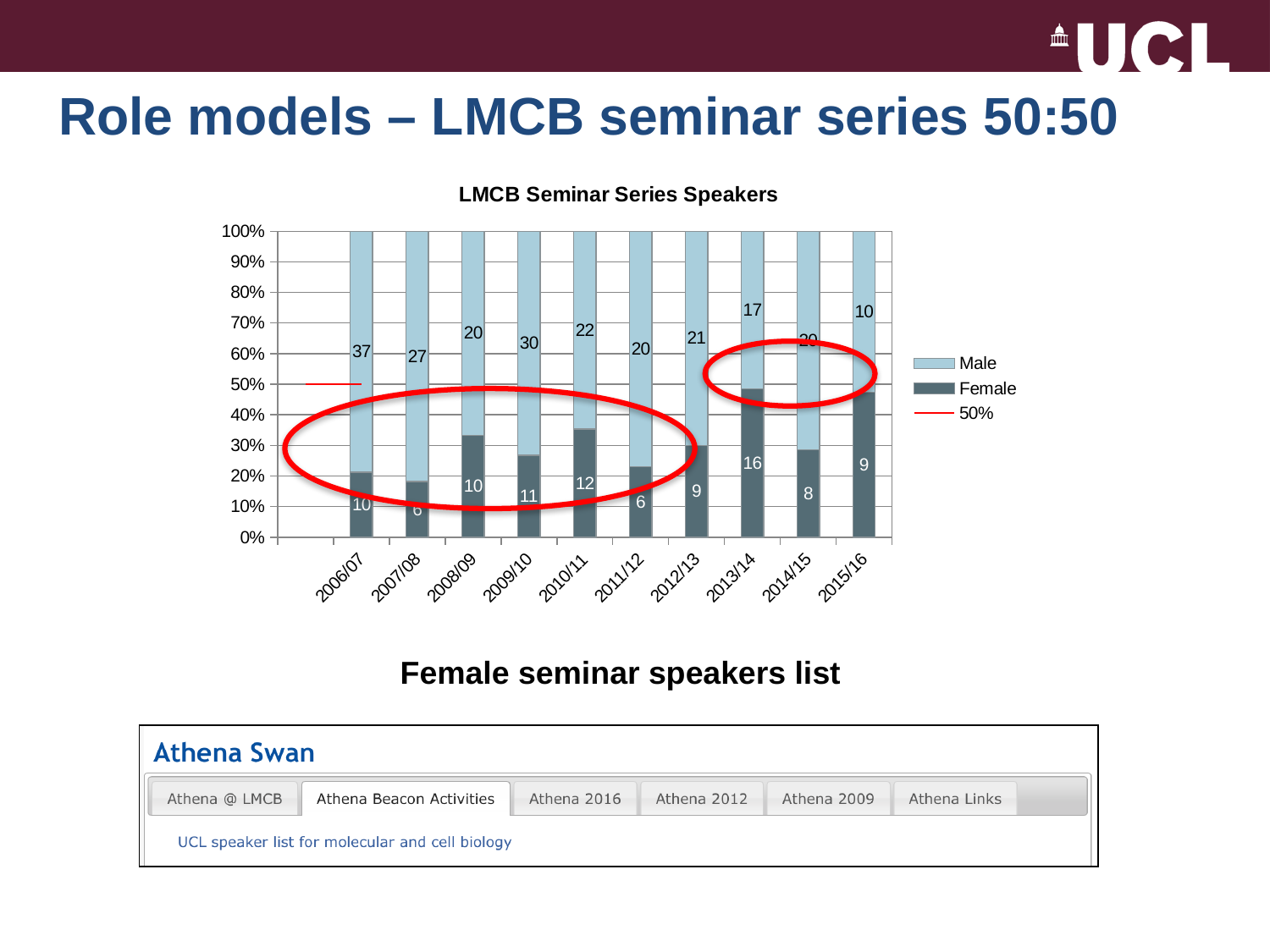
What is the total number of speakers (male plus female) in 2013/14? 33 How many male speakers are labelled for 2006/07? 37 How many academic years are shown on the x axis of the chart? 10 What is the difference between the male and female speaker counts in 2006/07? 27 How many female speakers are labelled for 2013/14? 16 How many female speakers are labelled for 2010/11? 12 How many male speakers are labelled for 2015/16? 10 How many entries does the chart legend list? 3 Which year has the highest labelled number of female speakers? 2013/14 What is the title of the chart? LMCB Seminar Series Speakers What kind of chart is shown on the slide? Stacked bar chart Is the female share of speakers in 2013/14 greater or less than 40%? greater